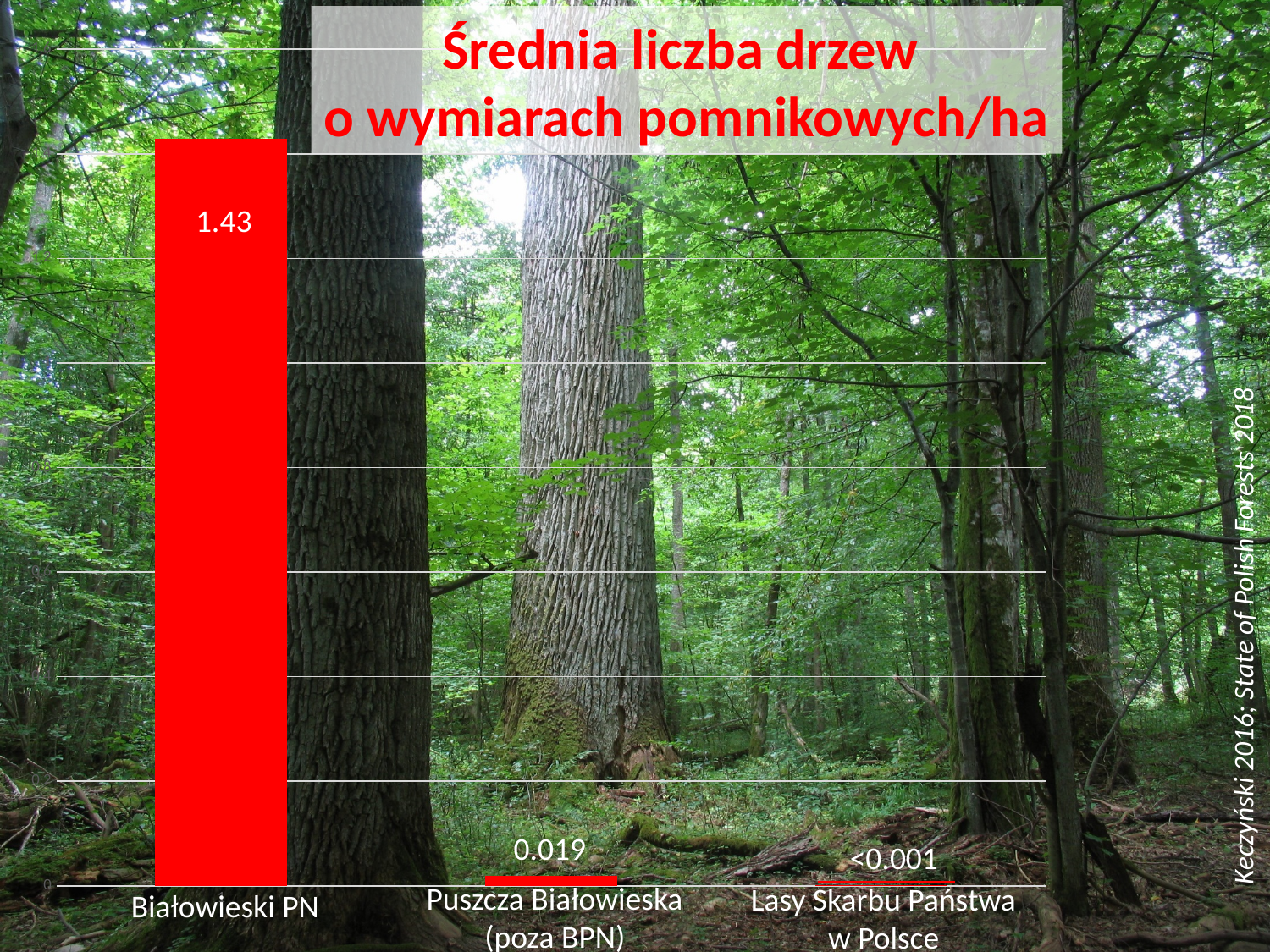
What value is shown for Lasy Skarbu Państwa w Polsce? <0.001 Do the values rise or fall from left to right across the categories? Fall What is the difference between the values for Białowieski PN and Puszcza Białowieska (poza BPN)? 1.411 Which is larger, the value for Puszcza Białowieska (poza BPN) or the value for Lasy Skarbu Państwa w Polsce? Puszcza Białowieska (poza BPN) What kind of chart is shown on the slide? Bar chart What is the title of the chart? Średnia liczba drzew o wymiarach pomnikowych/ha What colour are the bars in the chart? Red How many categories are shown in the chart? 3 Which category has the highest value? Białowieski PN Which category has the lowest value? Lasy Skarbu Państwa w Polsce What is the value for Białowieski PN? 1.43 What is the value for Puszcza Białowieska (poza BPN)? 0.019